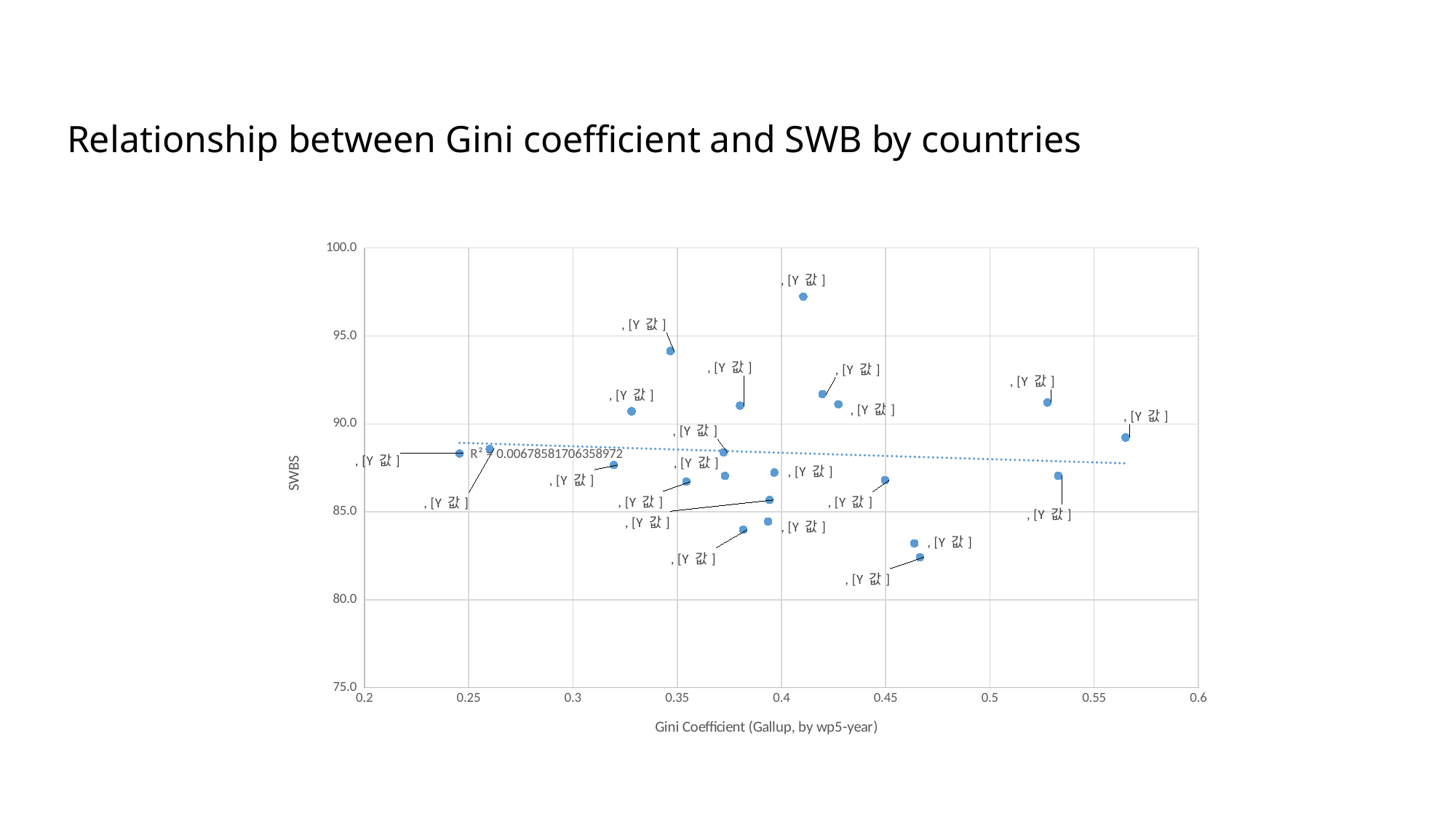
What is the title of the chart? Relationship between Gini coefficient and SWB by countries What R² value is printed next to the trendline? 0.00678581706358972 Which has the higher SWBS value: the point near Gini 0.41 or the point near Gini 0.465? The point near Gini 0.41 Is the SWBS value of the lowest point on the chart greater or less than 85.0? less Does the dotted trendline rise or fall as the Gini coefficient increases? Fall Is the SWBS value of the point with the smallest Gini coefficient (near 0.245) greater or less than 85.0? greater What kind of chart is shown on the slide? Scatter chart What is the label of the horizontal axis? Gini Coefficient (Gallup, by wp5-year) What is the maximum value shown on the vertical (SWBS) axis? 100.0 Is the SWBS value of the highest point on the chart greater or less than 95.0? greater